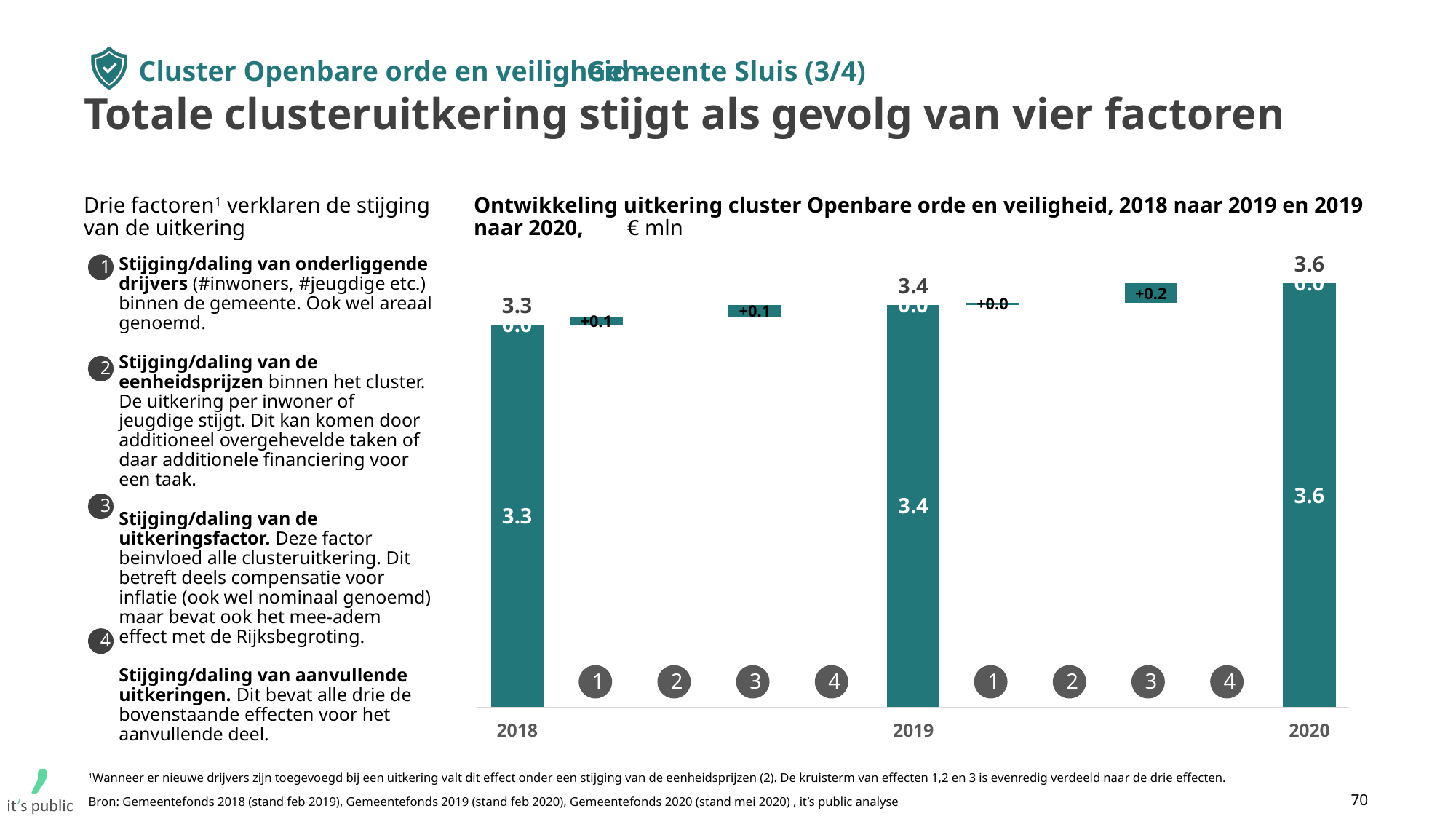
What is the labelled effect of factor 1 between 2019 and 2020? +0.0 In what unit are the values in the chart expressed? € mln Do the total cluster payments rise or fall from 2018 to 2020? rise Which year has the highest total cluster payment? 2020 Which year has the lowest total cluster payment? 2018 What is the total cluster payment shown for 2018? 3.3 What is the labelled effect of factor 3 (uitkeringsfactor) between 2019 and 2020? +0.2 What is the total cluster payment shown for 2020? 3.6 What is the labelled effect of factor 1 between 2018 and 2019? +0.1 By how much did the total cluster payment increase from 2018 to 2020? 0.3 How many year totals are shown in the chart? 3 What is the total cluster payment shown for 2019? 3.4